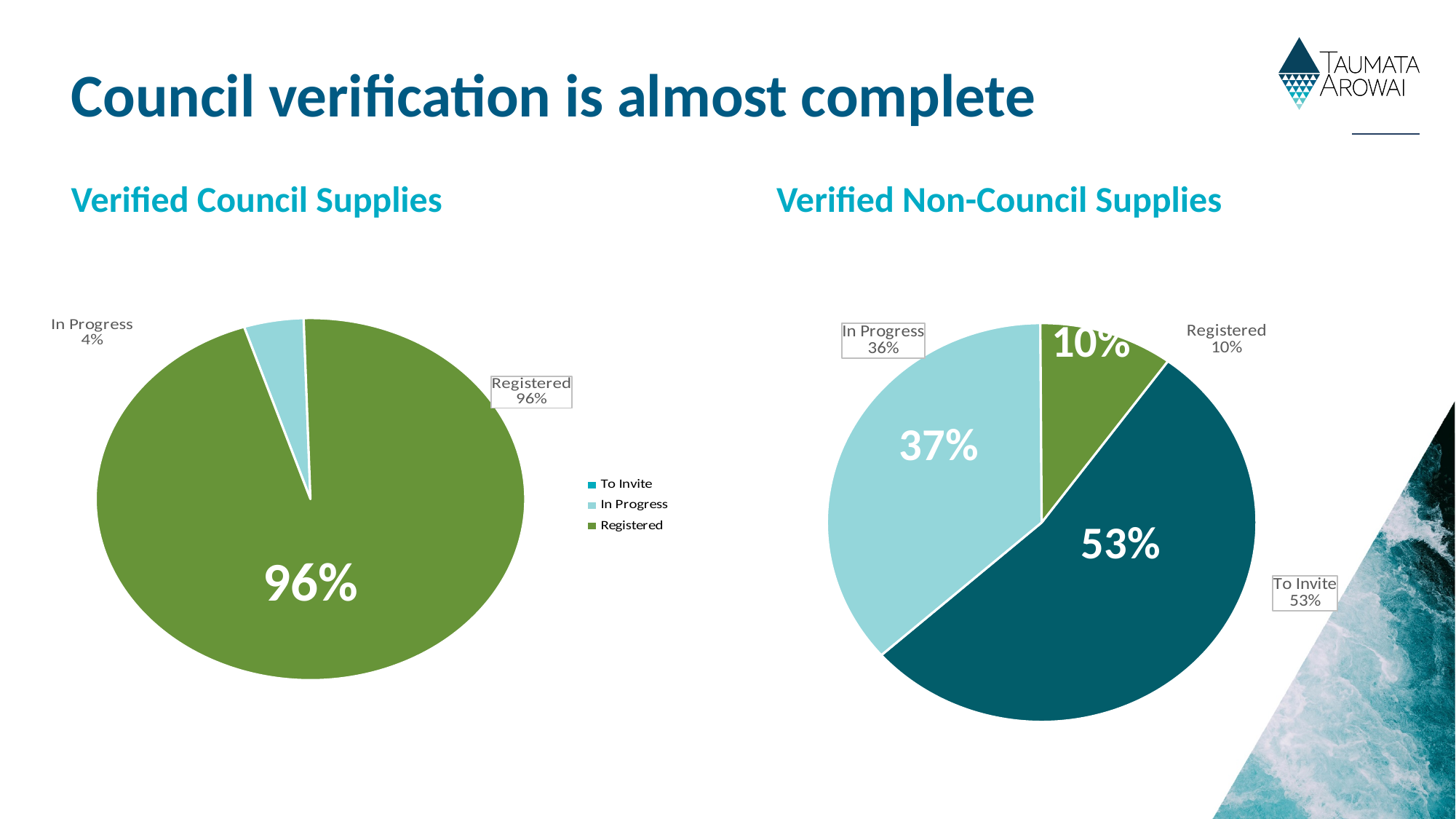
In the Verified Council Supplies chart, which category has the largest slice? Registered In the Verified Council Supplies chart, what is the difference between the Registered and In Progress shares? 92 percentage points How many slices does the Verified Non-Council Supplies pie chart have? 3 In the Verified Council Supplies chart, what share is In Progress? 4% In the Verified Non-Council Supplies chart, what share is Registered? 10% In the Verified Non-Council Supplies chart, which is larger, To Invite or Registered? To Invite How many entries does the legend of the Verified Council Supplies chart list? 3 In the Verified Non-Council Supplies chart, which category has the smallest slice? Registered In the Verified Non-Council Supplies chart, what share is To Invite? 53% In the Verified Non-Council Supplies chart, which category has the largest slice? To Invite What kind of chart is the Verified Council Supplies chart? Pie chart In the Verified Council Supplies chart, what share is Registered? 96%